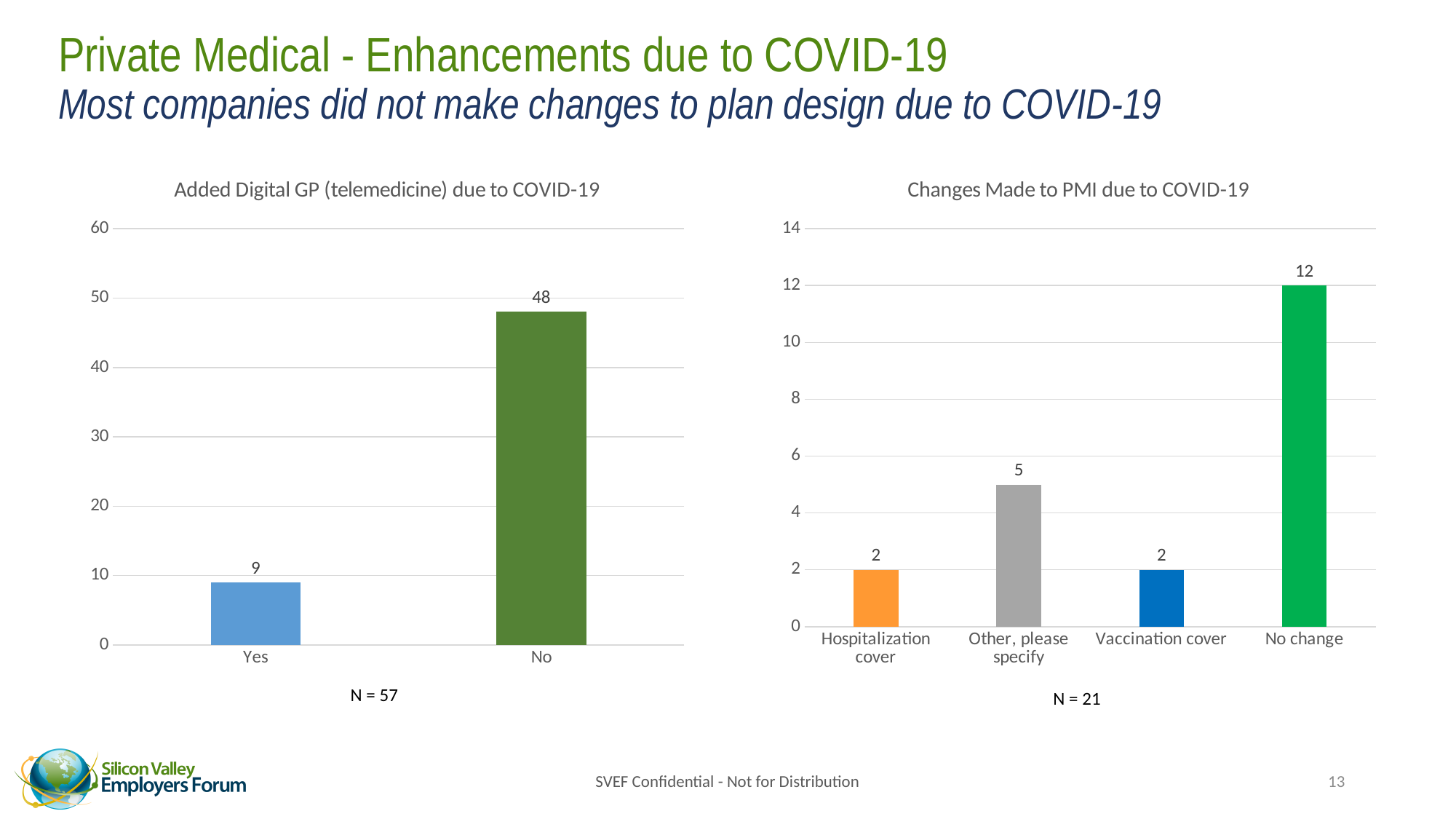
In the 'Changes Made to PMI due to COVID-19' chart, what is the value for 'No change'? 12 In the 'Added Digital GP (telemedicine) due to COVID-19' chart, what is the difference between the 'No' and 'Yes' values? 39 In the 'Changes Made to PMI due to COVID-19' chart, which category has the highest value? No change In the 'Changes Made to PMI due to COVID-19' chart, what is the value for 'Other, please specify'? 5 In the 'Added Digital GP (telemedicine) due to COVID-19' chart, what is the value for 'No'? 48 What is the sample size (N) shown under the 'Changes Made to PMI due to COVID-19' chart? N = 21 In the 'Added Digital GP (telemedicine) due to COVID-19' chart, what is the value for 'Yes'? 9 In the 'Changes Made to PMI due to COVID-19' chart, what is the difference between 'No change' and 'Hospitalization cover'? 10 In the 'Changes Made to PMI due to COVID-19' chart, which is larger: 'Other, please specify' or 'Vaccination cover'? Other, please specify What kind of chart is the 'Added Digital GP (telemedicine) due to COVID-19' chart? Bar chart In the 'Changes Made to PMI due to COVID-19' chart, how many categories are shown? 4 In the 'Added Digital GP (telemedicine) due to COVID-19' chart, how many categories are shown? 2